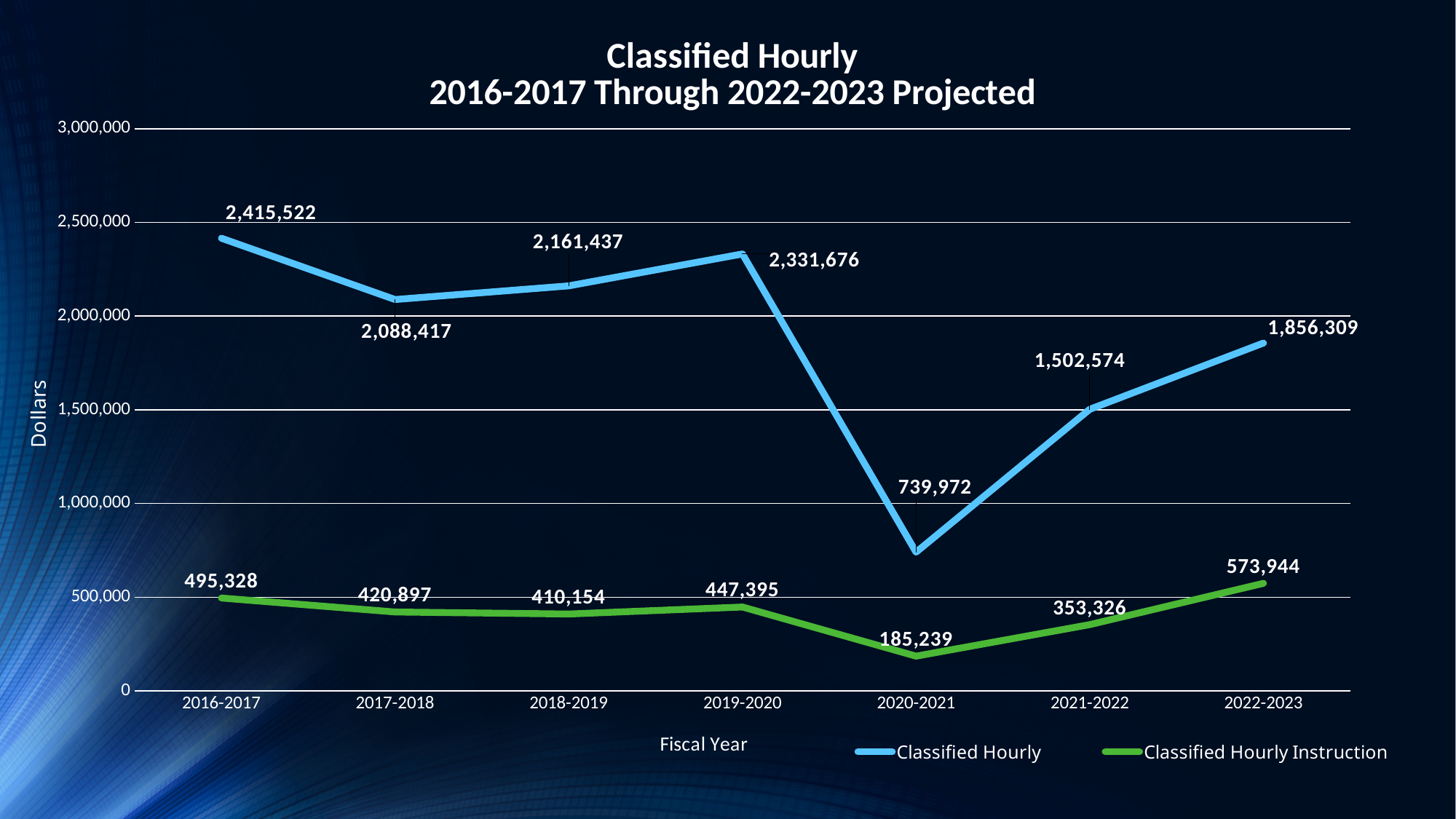
What is the difference between the Classified Hourly and Classified Hourly Instruction values in 2016-2017? 1,920,194 Is the Classified Hourly value for 2020-2021 greater or less than 1,000,000? less How many fiscal years are plotted on the x axis? 7 What is the Classified Hourly Instruction value for 2020-2021? 185,239 What is the Classified Hourly value for 2016-2017? 2,415,522 By how much did the Classified Hourly value drop from 2019-2020 to 2020-2021? 1,591,704 What kind of chart is shown on the slide? Line chart Which fiscal year has the lowest Classified Hourly Instruction value? 2020-2021 Which is larger, the Classified Hourly Instruction value for 2022-2023 or for 2016-2017? 2022-2023 What is the Classified Hourly value for 2022-2023? 1,856,309 Which fiscal year has the highest Classified Hourly value? 2016-2017 How many series does the legend list? 2